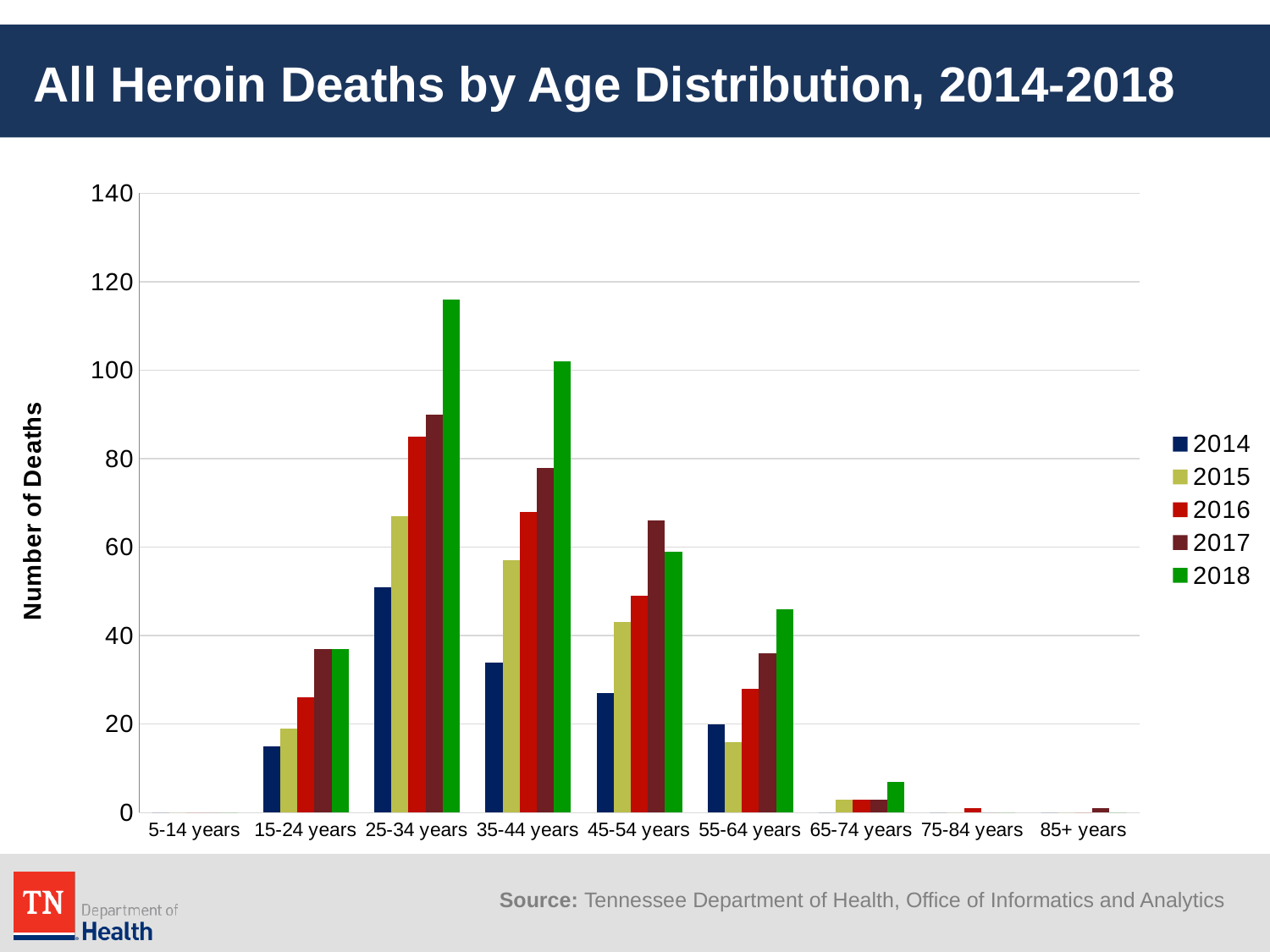
Is the value for 2015 in the 55-64 years group greater or less than 20? less How many age groups are shown on the x axis? 9 In the 45-54 years group, which year has more deaths, 2017 or 2018? 2017 Is the value for 2018 in the 25-34 years group greater or less than 100? greater Within the 25-34 years group, which year has the highest number of deaths? 2018 For the 25-34 years group, do the values rise or fall from 2014 to 2018? rise What is the label on the y axis? Number of Deaths Is the value for 2017 in the 45-54 years group greater or less than 60? greater Which age group has the tallest bar in the chart? 25-34 years What kind of chart is shown on the slide? bar chart How many years (series) does the legend list? 5